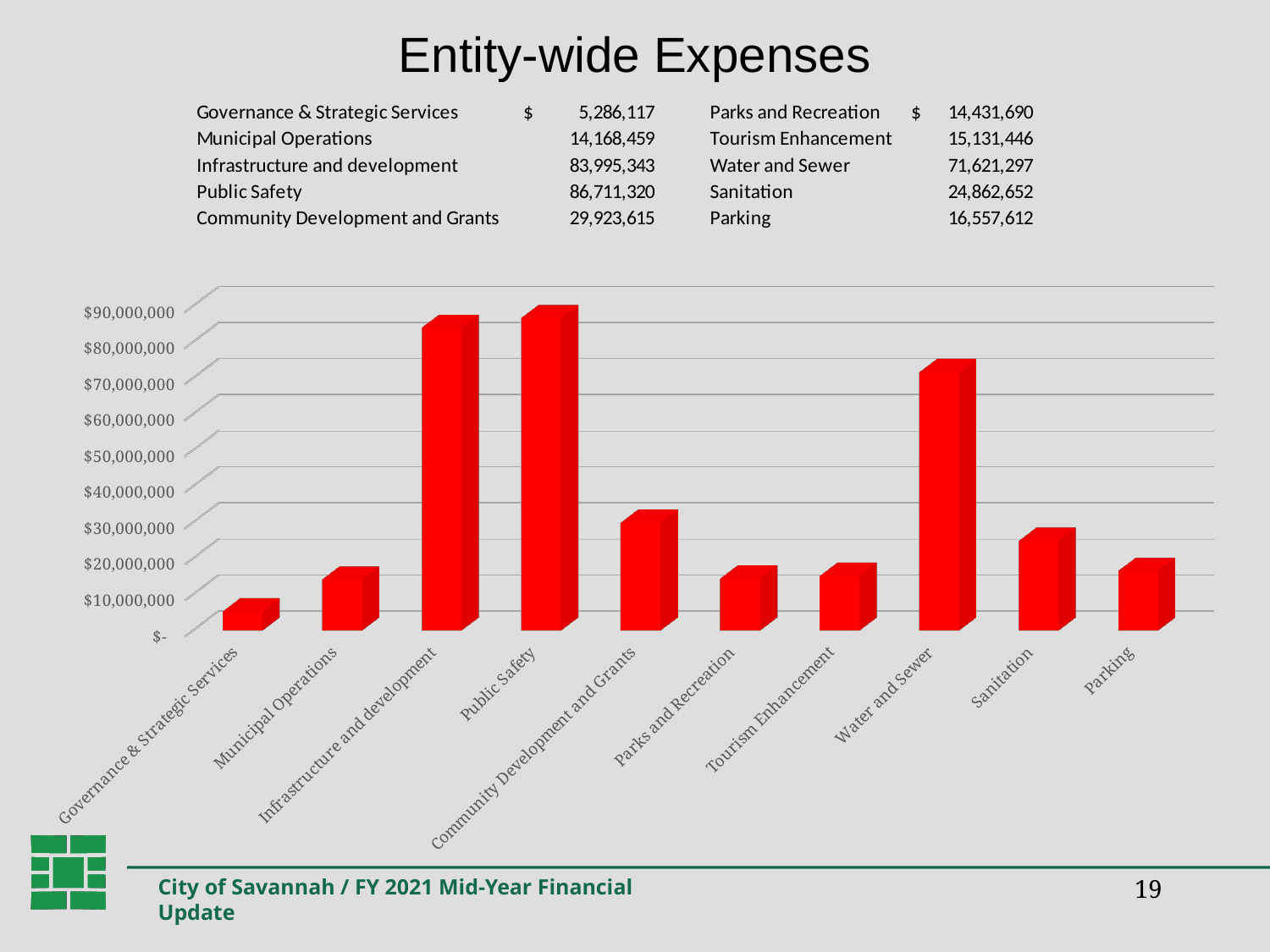
What is the value for Sanitation? 24,862,652 What is the difference between Sanitation and Parking? 8,305,040 Which category has the lowest expenses? Governance & Strategic Services Which category has the highest expenses? Public Safety How many categories are shown in the chart? 10 Which is larger, Water and Sewer or Community Development and Grants? Water and Sewer What is the value for Water and Sewer? 71,621,297 Is the value for Sanitation greater or less than $20,000,000? greater What is the value for Public Safety? 86,711,320 What is the title of the slide? Entity-wide Expenses What is the difference between Public Safety and Infrastructure and development? 2,715,977 What kind of chart is shown on the slide? bar chart